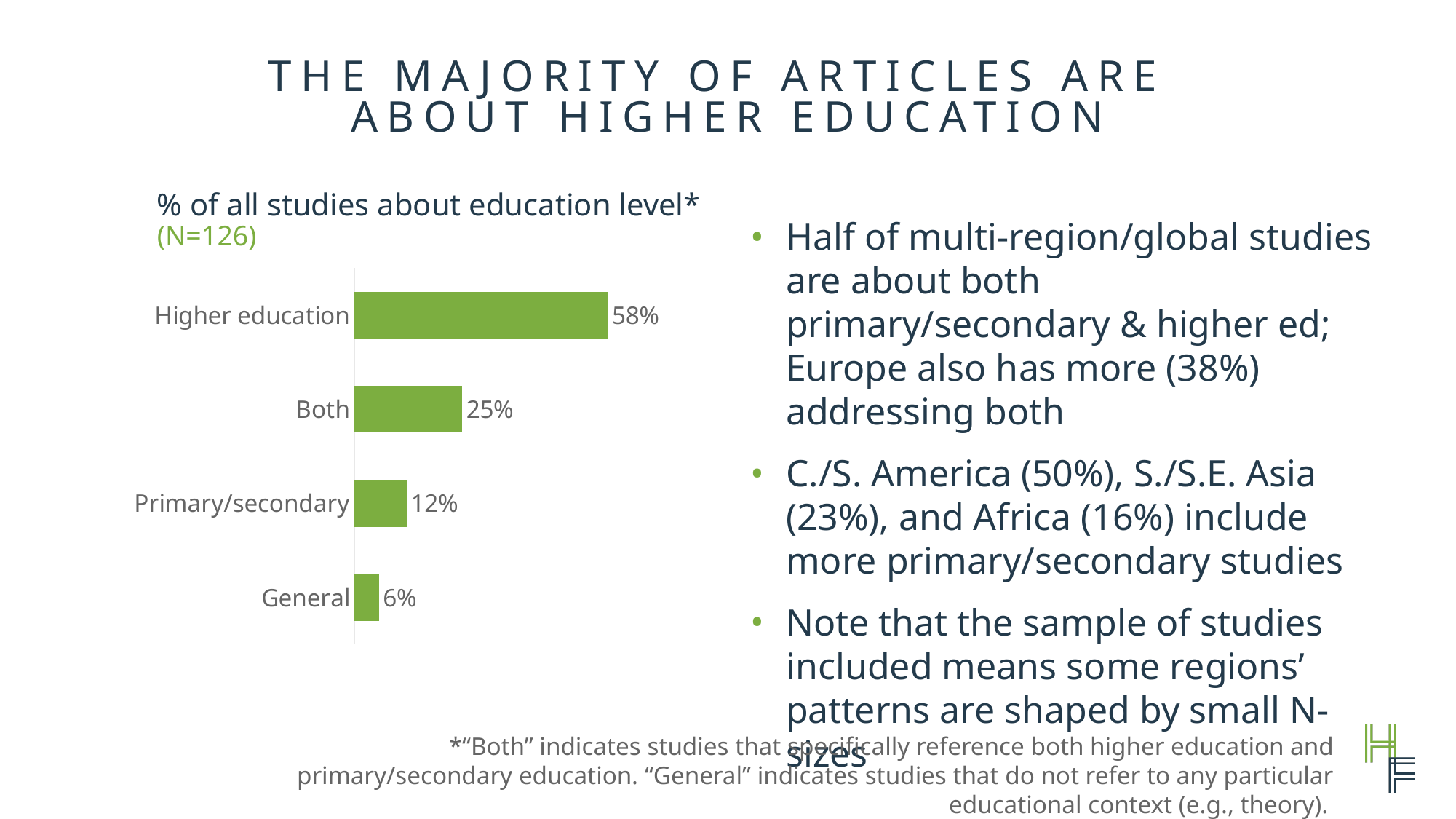
What is the difference in percentage points between Primary/secondary and General? 6 What percentage of studies are General? 6% What percentage of studies are about Both? 25% How many education level categories are shown in the chart? 4 Which education level category has the lowest share of studies? General What is the sample size (N) stated for the chart? N=126 Which education level category has the highest share of studies? Higher education What percentage of studies are about Higher education? 58% What percentage of studies are about Primary/secondary? 12% What is the difference in percentage points between Higher education and Both? 33 What type of chart is shown on the slide? Bar chart Which is larger, the share for Both or the share for Primary/secondary? Both